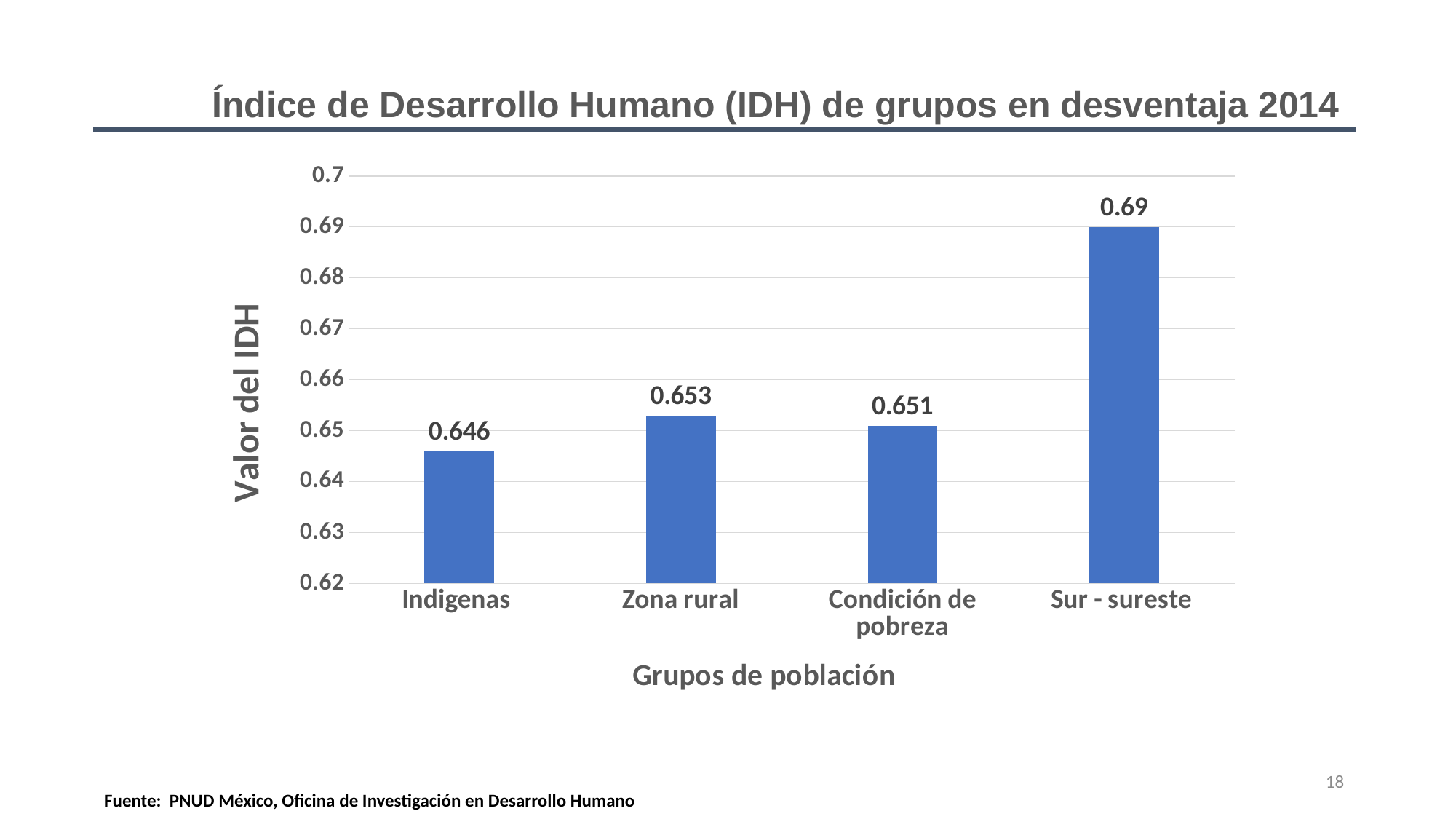
What is the label of the vertical axis? Valor del IDH What is the IDH value for Zona rural? 0.653 What is the IDH value for Condición de pobreza? 0.651 What is the IDH value for Sur - sureste? 0.69 Which population group has the highest IDH value? Sur - sureste Which population group has the lowest IDH value? Indigenas What is the difference between the IDH values of Sur - sureste and Indigenas? 0.044 What kind of chart is shown on the slide? Bar chart What is the IDH value for Indigenas? 0.646 Which has a higher IDH value, Zona rural or Indigenas? Zona rural What is the difference between the IDH values of Zona rural and Condición de pobreza? 0.002 How many population groups are shown in the chart? 4